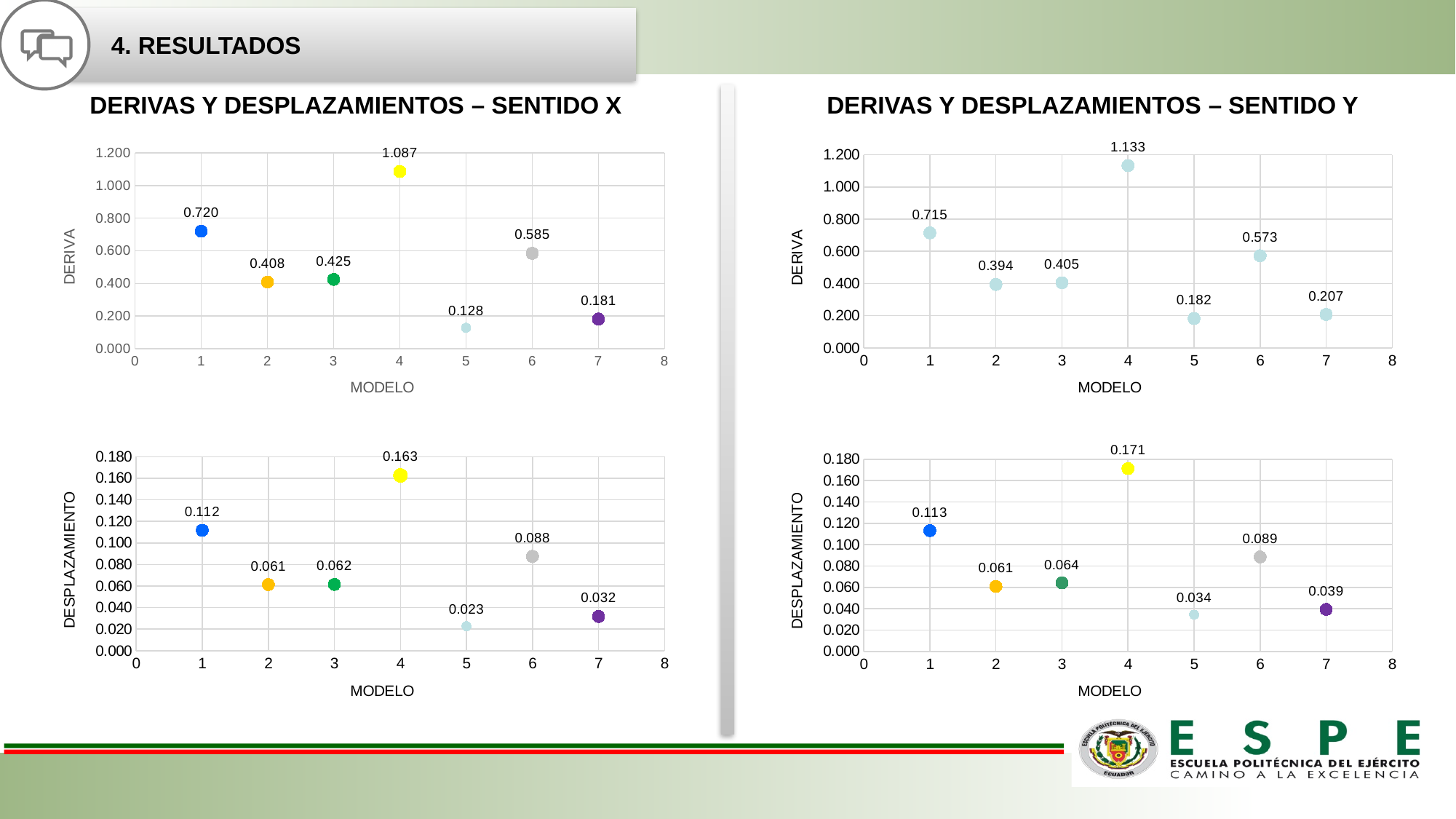
In the top-left chart (DERIVA, Sentido X), what is the value for modelo 4? 1.087 In the bottom-left chart (DESPLAZAMIENTO, Sentido X), what is the difference between the values for modelo 4 and modelo 1? 0.051 What is the x-axis title of the bottom-left chart (DESPLAZAMIENTO, Sentido X)? MODELO What kind of chart is the bottom-right chart (DESPLAZAMIENTO, Sentido Y)? scatter chart How many data points are plotted in the top-left chart (DERIVA, Sentido X)? 7 In the bottom-left chart (DESPLAZAMIENTO, Sentido X), what is the value for modelo 6? 0.088 In the top-right chart (DERIVA, Sentido Y), which modelo has the highest deriva? 4 In the bottom-right chart (DESPLAZAMIENTO, Sentido Y), what is the value for modelo 5? 0.034 In the top-left chart (DERIVA, Sentido X), which modelo has the lowest deriva? 5 In the top-right chart (DERIVA, Sentido Y), is the value for modelo 6 greater or less than 0.400? greater In the top-right chart (DERIVA, Sentido Y), what is the value for modelo 7? 0.207 In the bottom-right chart (DESPLAZAMIENTO, Sentido Y), which is larger, the value for modelo 1 or modelo 6? modelo 1